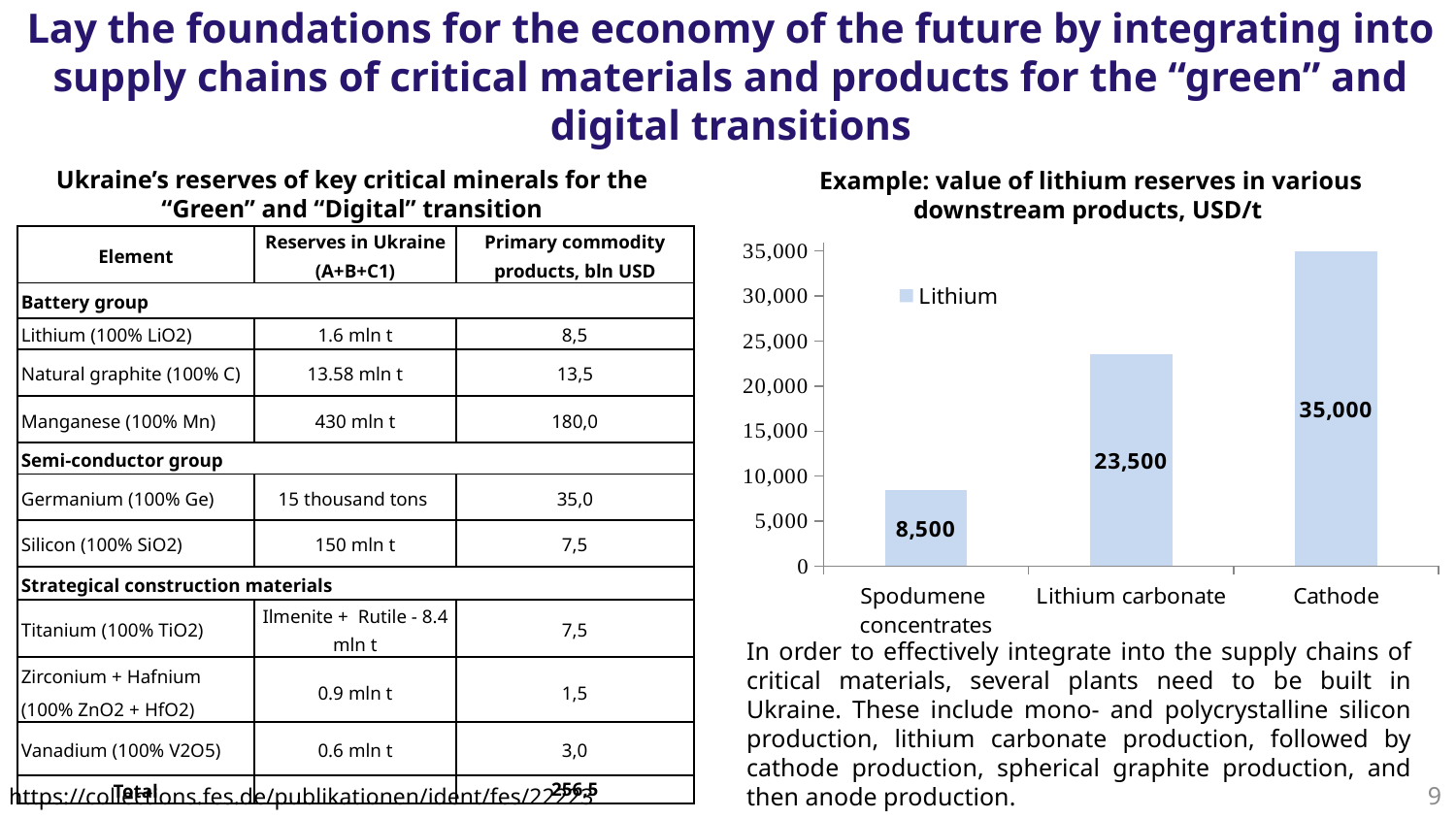
Which downstream product has the highest value in the chart? Cathode What is the value for Lithium carbonate in the chart? 23,500 What kind of chart is shown on the slide? Bar chart What is the value for Cathode in the chart? 35,000 How many categories are shown on the x axis of the chart? 3 Which downstream product has the lowest value in the chart? Spodumene concentrates Is the value for Lithium carbonate greater or less than 20,000? greater What is the value for Spodumene concentrates in the chart? 8,500 What is the difference between the values for Cathode and Lithium carbonate? 11,500 What is the difference between the values for Lithium carbonate and Spodumene concentrates? 15,000 Which is larger, the value for Lithium carbonate or the value for Spodumene concentrates? Lithium carbonate Do the values rise or fall from Spodumene concentrates to Cathode along the x axis? Rise